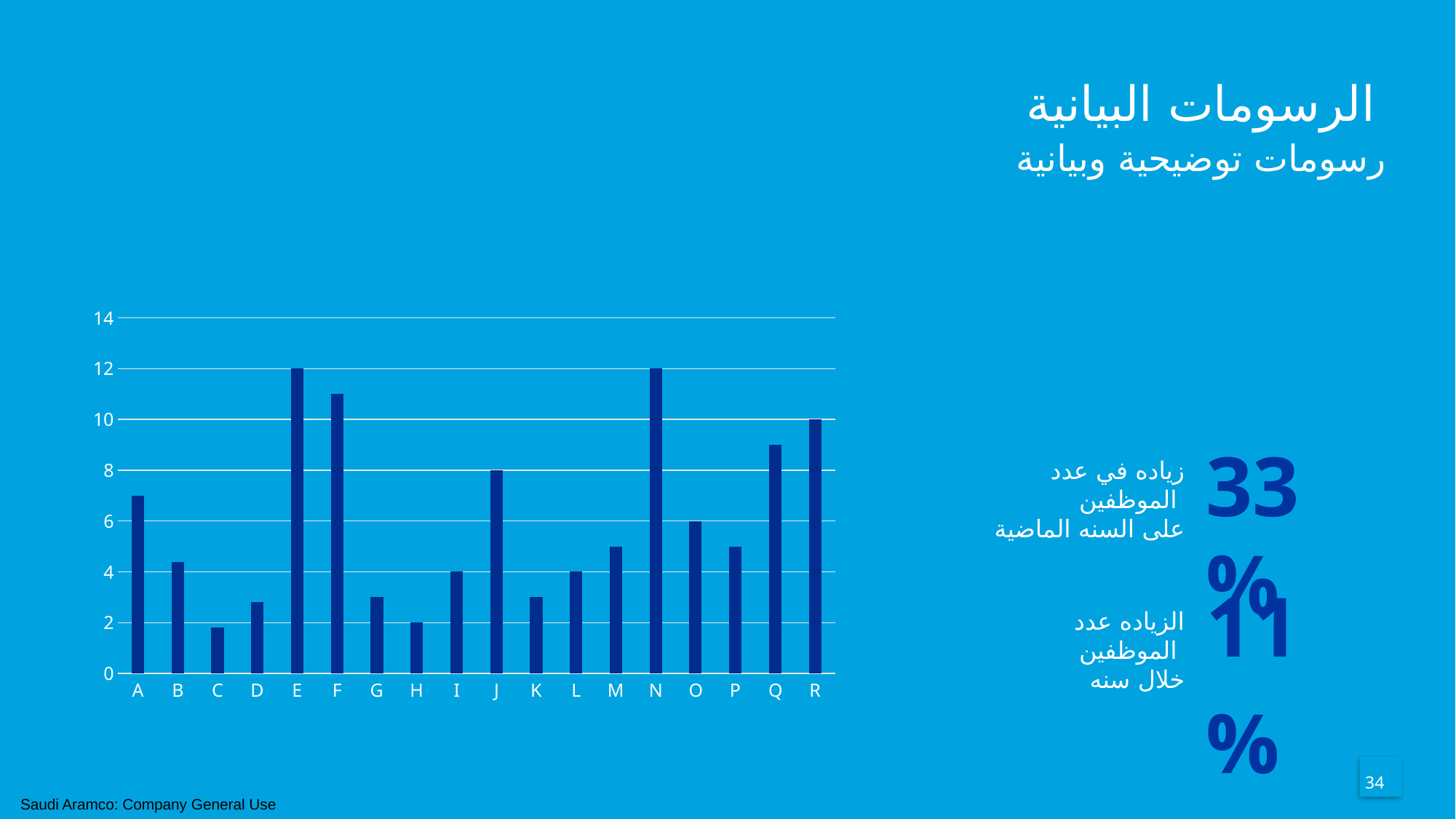
Is the value for F greater or less than 10? greater Is the value for Q greater or less than 8? greater What is the value for category N in the bar chart? 12 Which is larger, the value for G or the value for Q? Q What is the value for category J in the bar chart? 8 What kind of chart is shown on the slide? bar chart What is the value for category R in the bar chart? 10 Which is larger, the value for E or the value for C? E Is the value for C greater or less than 4? less What is the value for category O in the bar chart? 6 How many categories are shown on the x axis of the bar chart? 18 What is the value for category E in the bar chart? 12